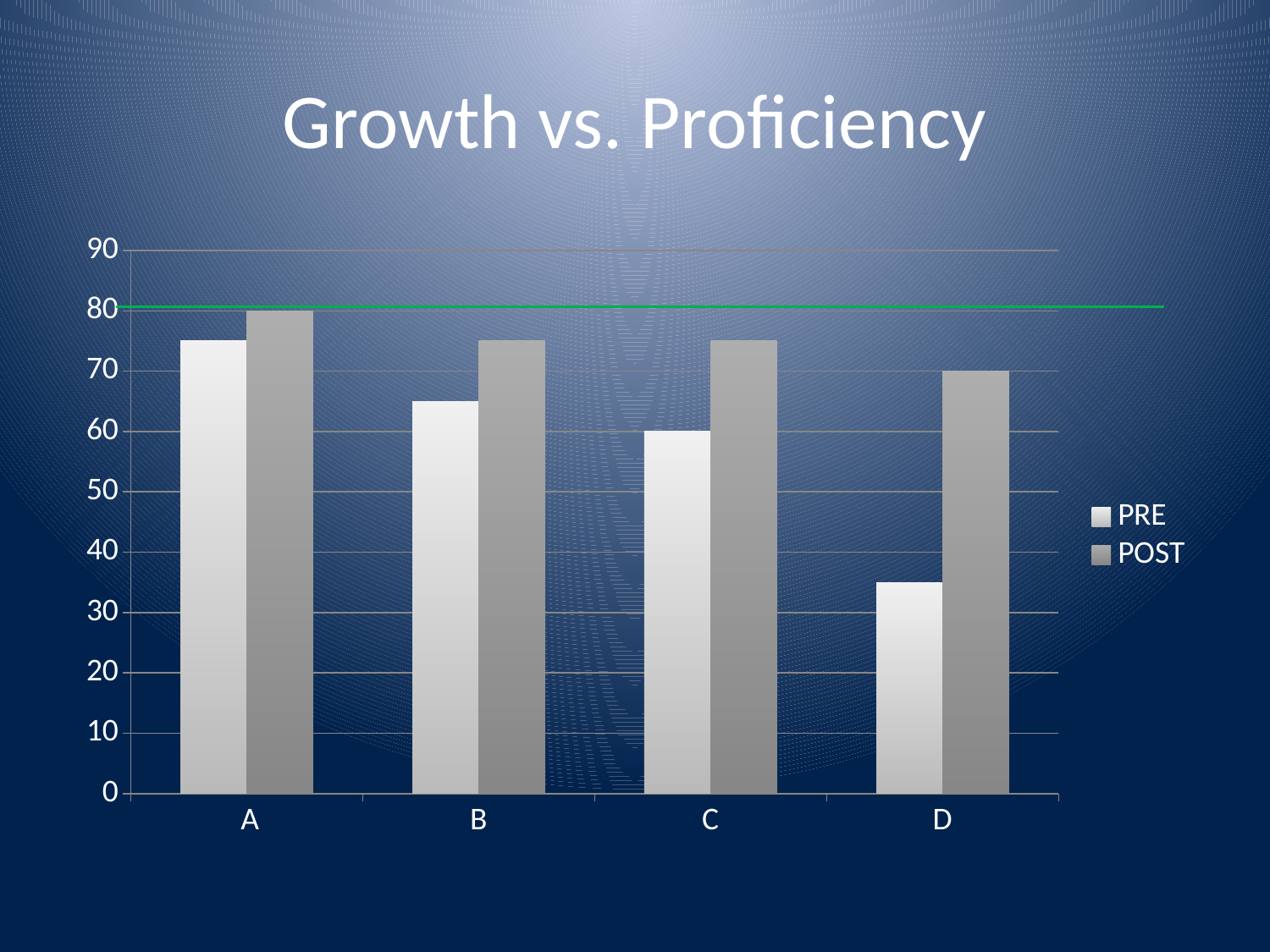
For category D, which is larger, the PRE value or the POST value? POST Which category has the highest POST value? A Is the PRE value for D greater or less than 40? less Which category has the highest PRE value? A How many series does the legend list? 2 Do the PRE values rise or fall from A to D? fall How many categories are shown on the x axis? 4 What is the title of the chart? Growth vs. Proficiency Which category has the lowest POST value? D What kind of chart is shown on the slide? bar chart Which category has the lowest PRE value? D Is the POST value for B greater or less than 70? greater